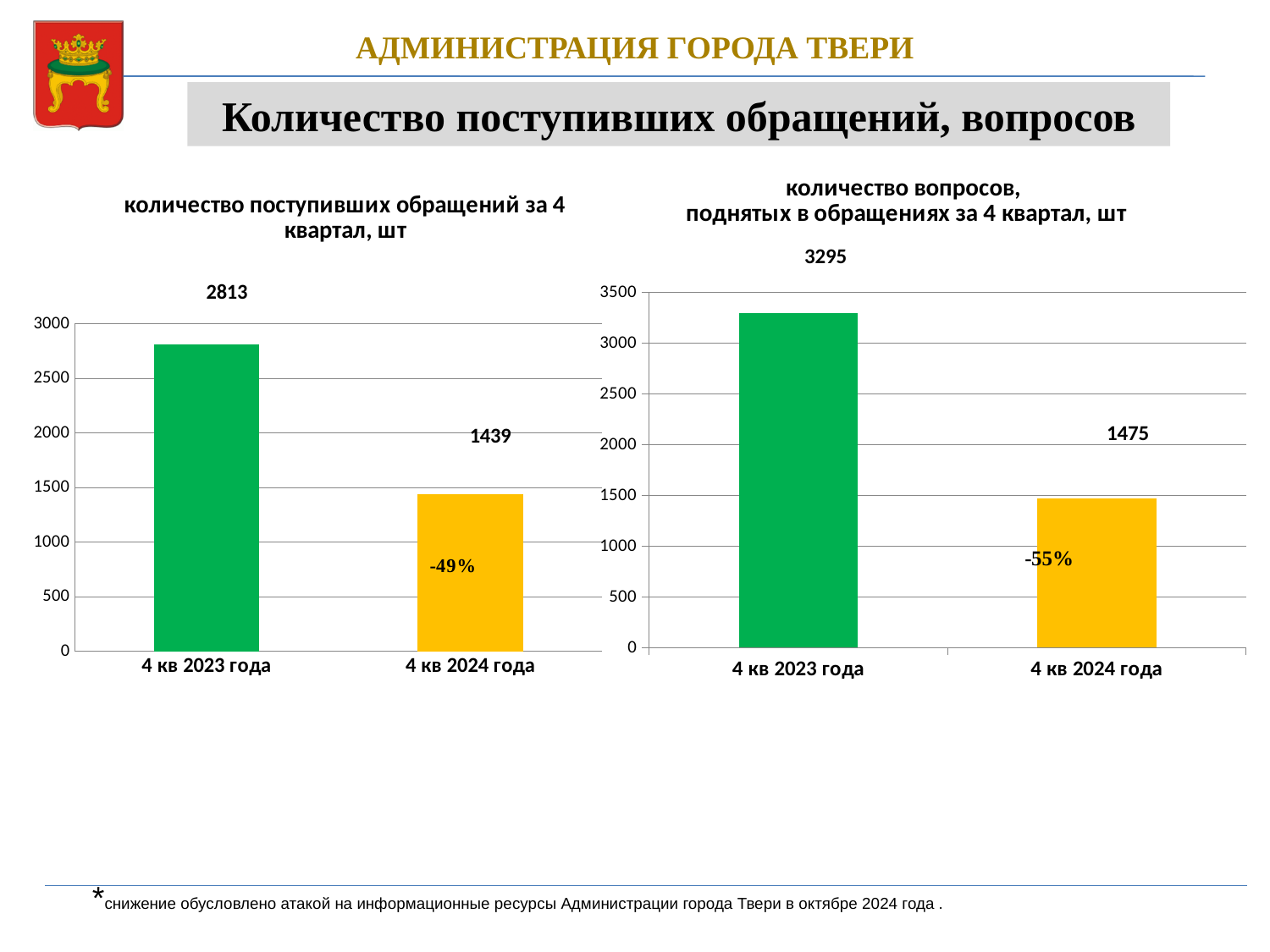
In the right chart (количество вопросов, поднятых в обращениях за 4 квартал, шт), what is the value for 4 кв 2023 года? 3295 In the right chart, is the value for 4 кв 2023 года greater or less than 3000? greater In the right chart (количество вопросов, поднятых в обращениях за 4 квартал, шт), what is the value for 4 кв 2024 года? 1475 What kind of chart is the right chart? bar chart In the left chart (количество поступивших обращений за 4 квартал, шт), what is the value for 4 кв 2023 года? 2813 In the left chart (количество поступивших обращений за 4 квартал, шт), what is the value for 4 кв 2024 года? 1439 In the right chart, what is the difference between the values for 4 кв 2023 года and 4 кв 2024 года? 1820 How many categories does the left chart show? 2 In the left chart, what is the difference between the values for 4 кв 2023 года and 4 кв 2024 года? 1374 In the right chart, which category has the lowest value? 4 кв 2024 года In the left chart, what percentage change is printed on the bar for 4 кв 2024 года? -49% In the left chart, which category has the highest value? 4 кв 2023 года